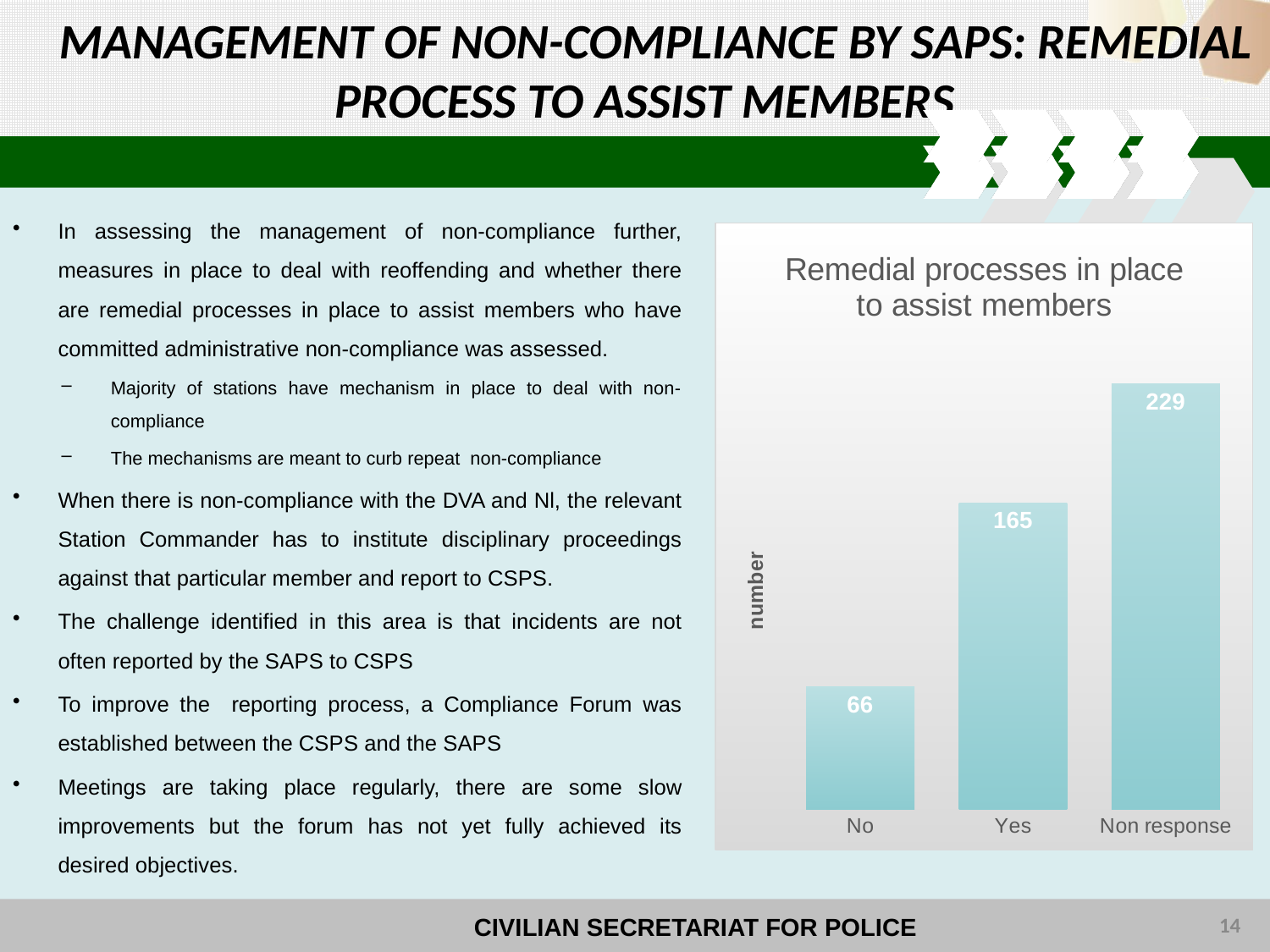
Which category has the highest value in the chart? Non response How many categories are shown in the chart? 3 What is the value for "Non response" in the chart? 229 What kind of chart is shown on the slide? Bar chart What is the value for "Yes" in the chart? 165 What is the difference between the values for "Yes" and "No"? 99 What is the difference between the values for "Non response" and "Yes"? 64 Do the values rise or fall from left to right across the categories? Rise What is the title of the chart? Remedial processes in place to assist members Which is larger, the value for "Yes" or the value for "No"? Yes Which category has the lowest value in the chart? No What is the value for "No" in the chart? 66